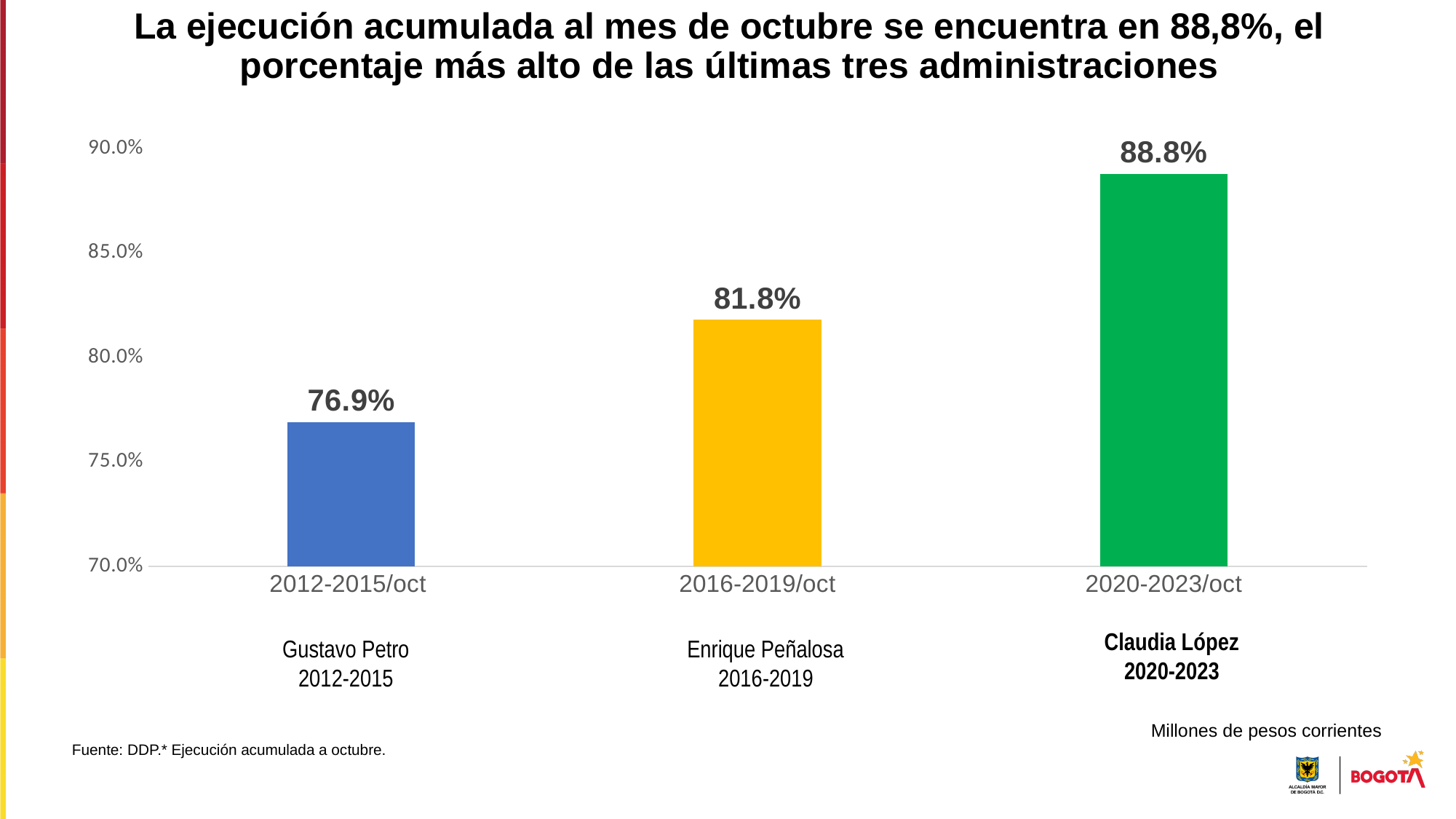
Which category has the highest value? 2020-2023/oct Do the values rise or fall from left to right along the x axis? rise Which is larger, the value for 2016-2019/oct or the value for 2012-2015/oct? 2016-2019/oct How many bars are shown in the chart? 3 What is the difference between the values for 2016-2019/oct and 2012-2015/oct? 4.9% Which category has the lowest value? 2012-2015/oct What is the value for 2020-2023/oct? 88.8% What kind of chart is shown on the slide? bar chart Is the value for 2016-2019/oct greater or less than 80.0%? greater What is the value for 2016-2019/oct? 81.8% What is the value for 2012-2015/oct? 76.9% What is the difference between the values for 2020-2023/oct and 2012-2015/oct? 11.9%